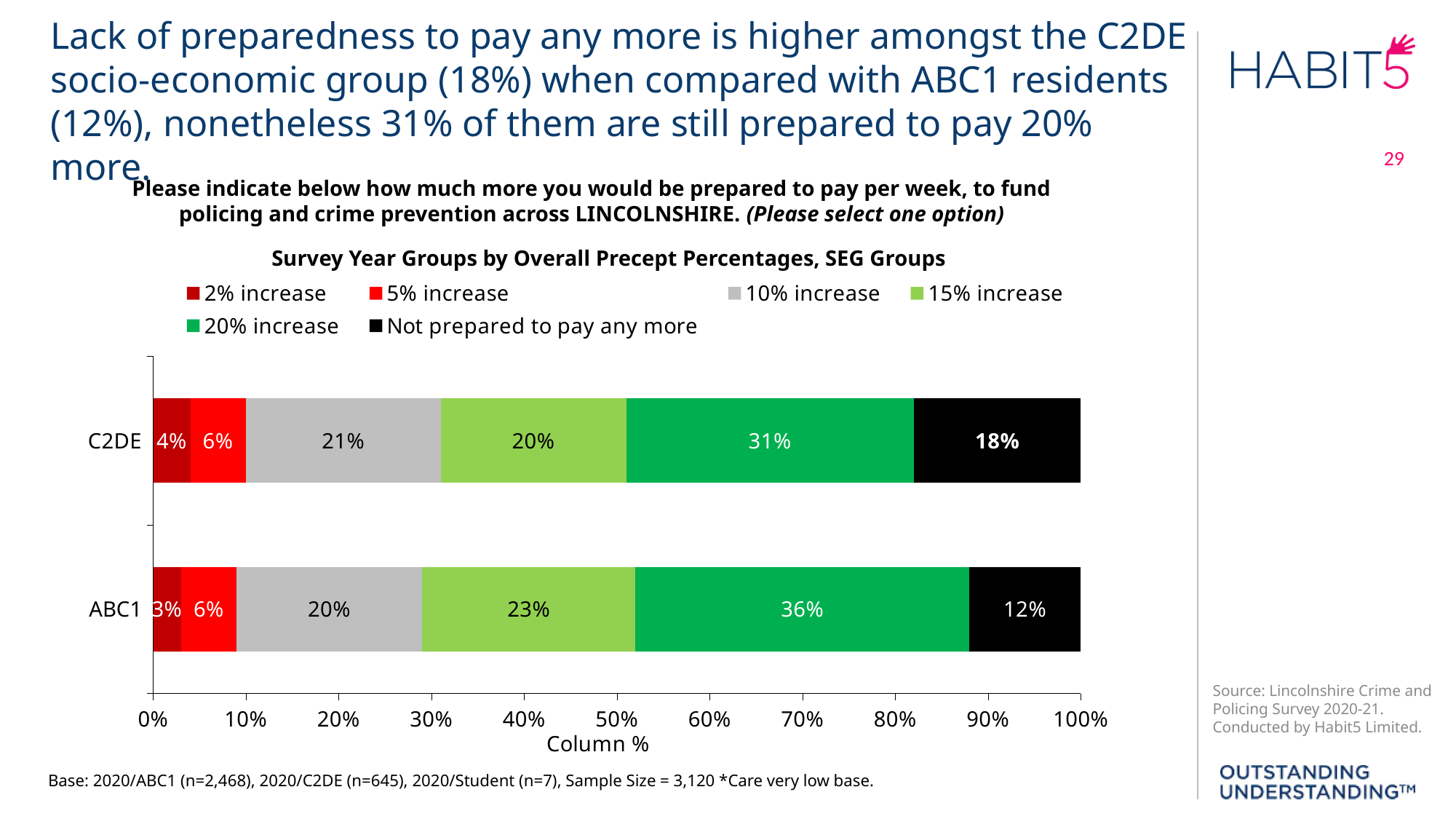
What is the difference between the C2DE and ABC1 shares for 'Not prepared to pay any more'? 6% What is the difference between the ABC1 and C2DE shares for a 20% increase? 5% Which group has the higher share of respondents not prepared to pay any more, C2DE or ABC1? C2DE What percentage of ABC1 respondents would accept a 20% increase? 36% What type of chart is shown on the slide? Stacked bar chart Which response option has the smallest share among ABC1 respondents? 2% increase Which response option has the largest share among C2DE respondents? 20% increase How many socio-economic groups are shown on the chart? 2 How many series does the legend list? 6 What percentage of ABC1 respondents would accept a 15% increase? 23% What percentage of C2DE respondents are not prepared to pay any more? 18% What percentage of C2DE respondents would accept a 10% increase? 21%